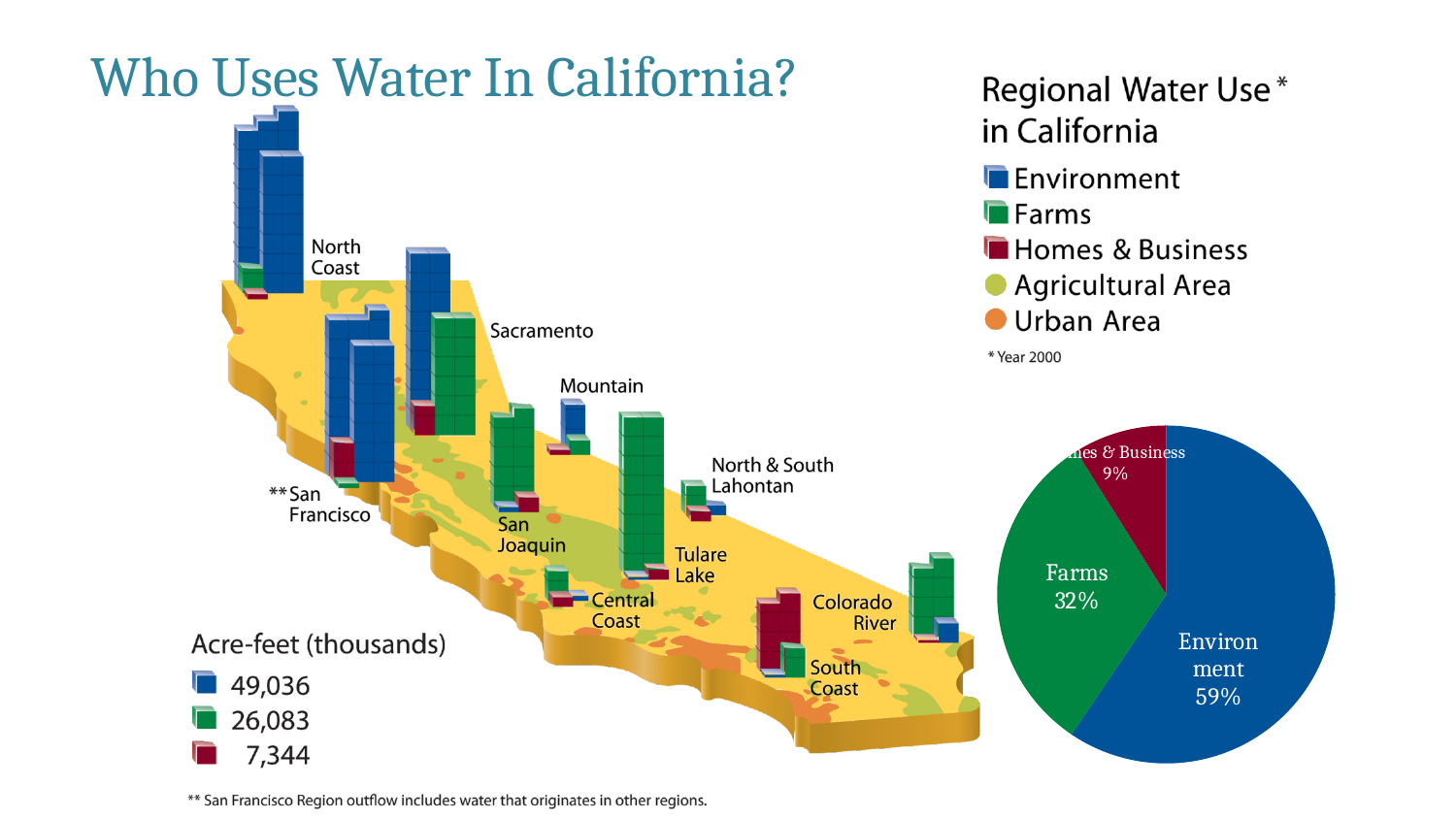
In the pie chart, what share of water use is attributed to Environment? 59% In the pie chart, which is larger: the Farms share or the Homes & Business share? Farms What kind of chart is shown on the right side of the slide? Pie chart How many slices does the pie chart have? 3 What year does the Regional Water Use data refer to, according to the footnote? 2000 In the pie chart, how many percentage points larger is the Environment share than the Farms share? 27 In the pie chart, what share of water use is attributed to Homes & Business? 9% According to the acre-feet (thousands) key, how many thousand acre-feet does the blue (Environment) category represent? 49,036 In the pie chart, which category has the smallest share of water use? Homes & Business According to the acre-feet (thousands) key, how many thousand acre-feet does the red (Homes & Business) category represent? 7,344 In the pie chart, which category has the largest share of water use? Environment In the pie chart, what share of water use is attributed to Farms? 32%